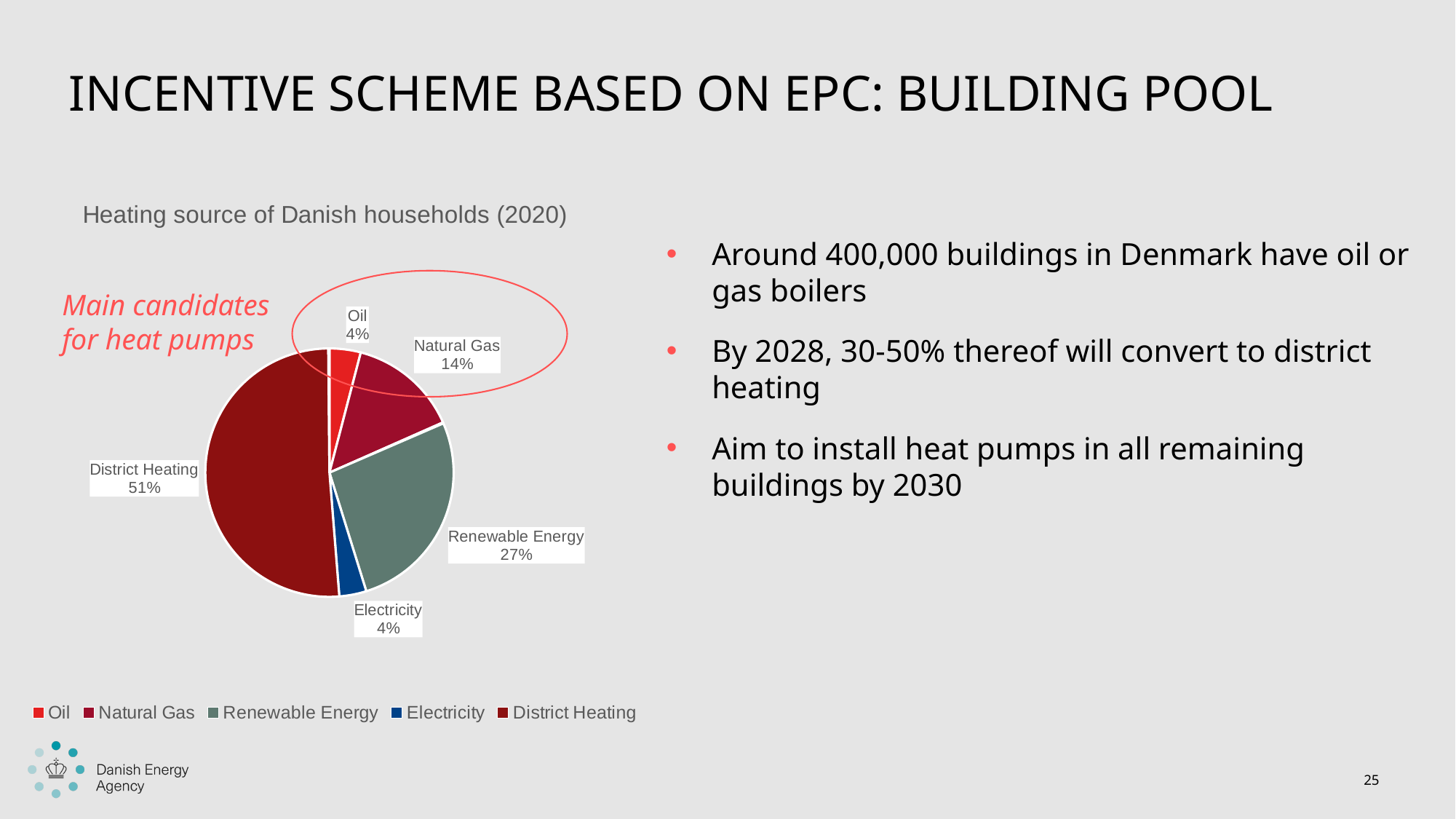
What percentage of Danish households used Oil for heating in 2020? 4% Which two heating sources are circled as the main candidates for heat pumps? Oil and Natural Gas What share of Danish households used District Heating as their heating source in 2020? 51% How many heating source categories are shown in the pie chart? 5 What is the combined share of Oil and Natural Gas in the pie chart? 18% What is the difference in percentage points between District Heating and Renewable Energy? 24 Which has a larger share, Natural Gas or Renewable Energy? Renewable Energy What share does Natural Gas have in the heating source pie chart? 14% What percentage of the pie chart is Renewable Energy? 27% What is the title of the chart on the slide? Heating source of Danish households (2020) What type of chart is used to show the heating source of Danish households? Pie chart Which heating source has the largest share in the pie chart? District Heating